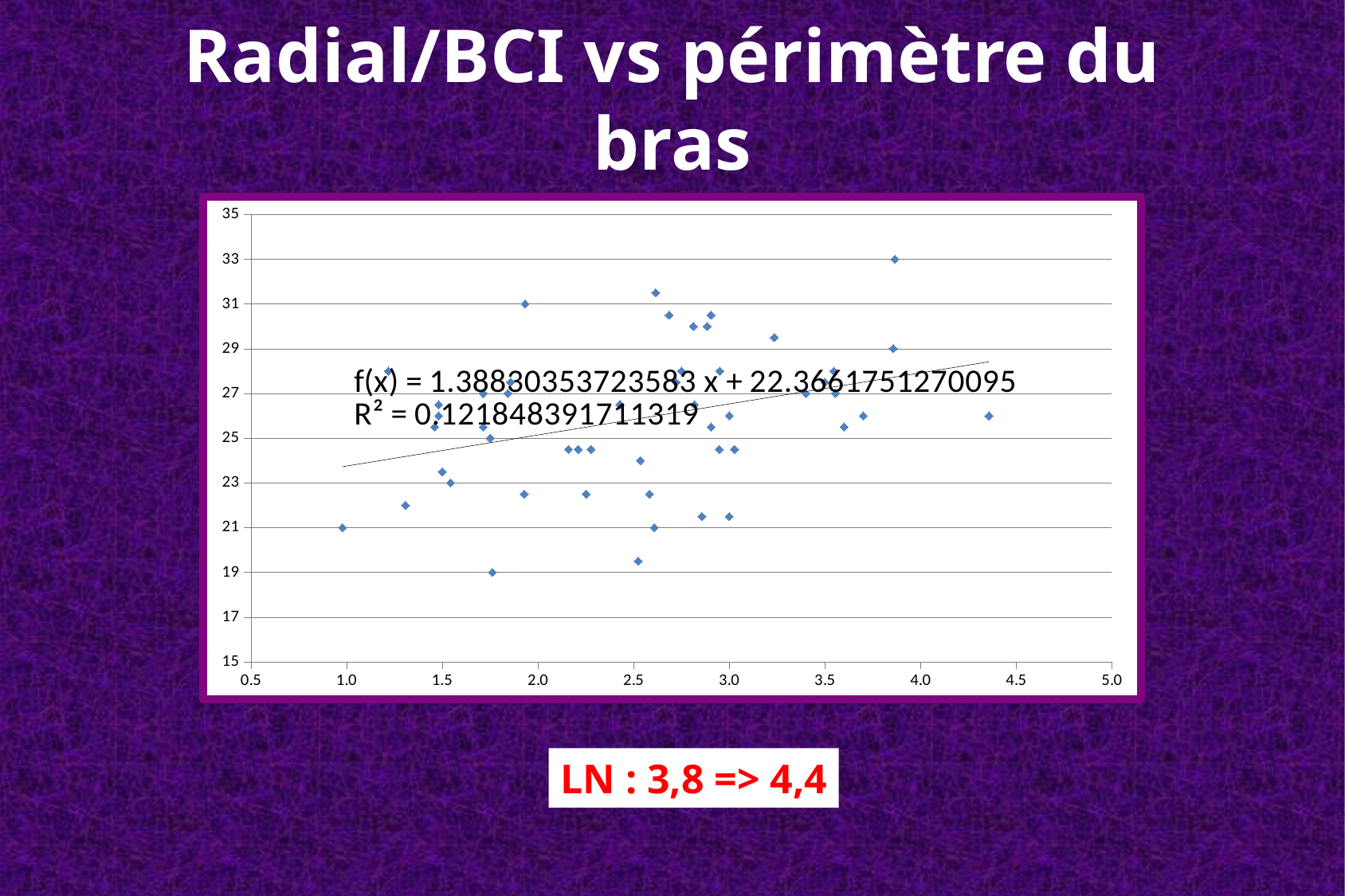
Is the y value of the point at x ≈ 1.0 greater or less than 23? less Is the y value of the point near x ≈ 3.85 that lies highest greater or less than 31? greater Is the y value of the highest point on the chart greater or less than 31? greater What is the equation of the fitted line printed on the chart? f(x) = 1.38830353723583 x + 22.3661751270095 What is the R² value printed on the chart? 0.121848391711319 Does the fitted trendline rise or fall as the x value increases? rises What kind of chart is shown on the slide? scatter chart